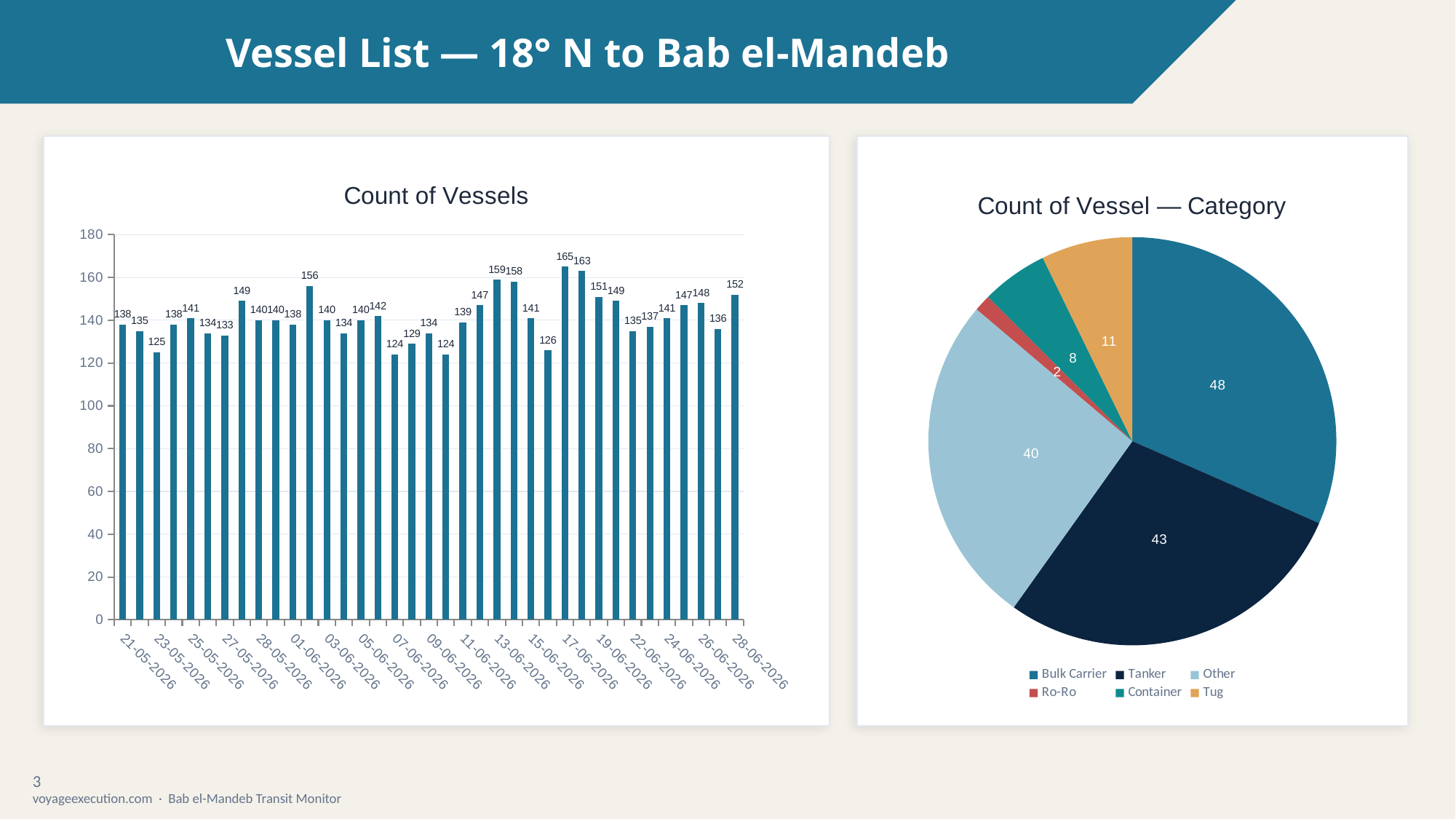
In the "Count of Vessel — Category" pie chart, what is the value for Tanker? 43 What kind of chart is the "Count of Vessel — Category" chart on the right? Pie chart In the "Count of Vessels" chart, what is the lowest value shown? 124 What kind of chart is the "Count of Vessels" chart on the left? Bar chart How many categories does the legend of the "Count of Vessel — Category" pie chart list? 6 In the "Count of Vessel — Category" pie chart, which is larger, Tug or Container? Tug In the "Count of Vessels" chart, what is the highest value shown? 165 In the "Count of Vessel — Category" pie chart, which category has the smallest slice? Ro-Ro In the "Count of Vessels" chart, what is the value for 28-06-2026? 152 In the "Count of Vessels" chart, what is the value for 21-05-2026? 138 In the "Count of Vessel — Category" pie chart, what is the difference between the Bulk Carrier and Tanker values? 5 In the "Count of Vessel — Category" pie chart, what is the value for Bulk Carrier? 48